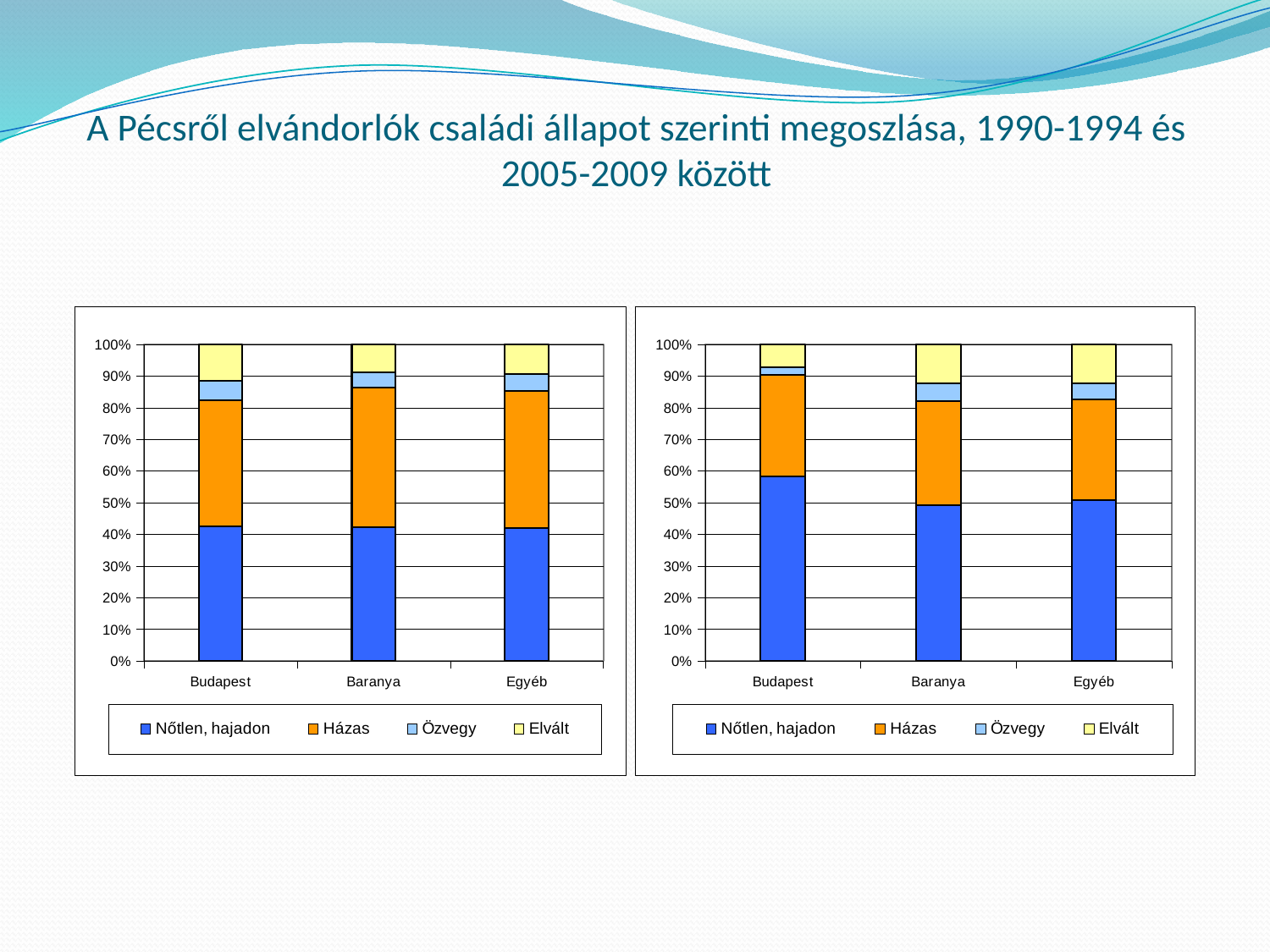
What kind of chart is the chart on the left side of the slide? stacked bar chart How many series does the legend of the chart on the left side of the slide list? 4 How many categories are shown on the x axis of the chart on the right side of the slide? 3 In the chart on the left side of the slide, is the Házas share larger for Budapest or for Baranya? Baranya In the chart on the right side of the slide, is the value for Nőtlen, hajadon in Budapest greater or less than 60%? less In the chart on the left side of the slide, is the value for Nőtlen, hajadon in Budapest greater or less than 50%? less In the chart on the right side of the slide, is the value for Nőtlen, hajadon in Budapest greater or less than 50%? greater In the chart on the right side of the slide, which category has the largest Nőtlen, hajadon share? Budapest Which series is shown in orange in the chart on the left side of the slide? Házas In the chart on the right side of the slide, is the Nőtlen, hajadon share larger for Budapest or for Baranya? Budapest What does each stacked bar in the chart on the right side of the slide total? 100% What are the legend entries of the chart on the right side of the slide? Nőtlen, hajadon; Házas; Özvegy; Elvált